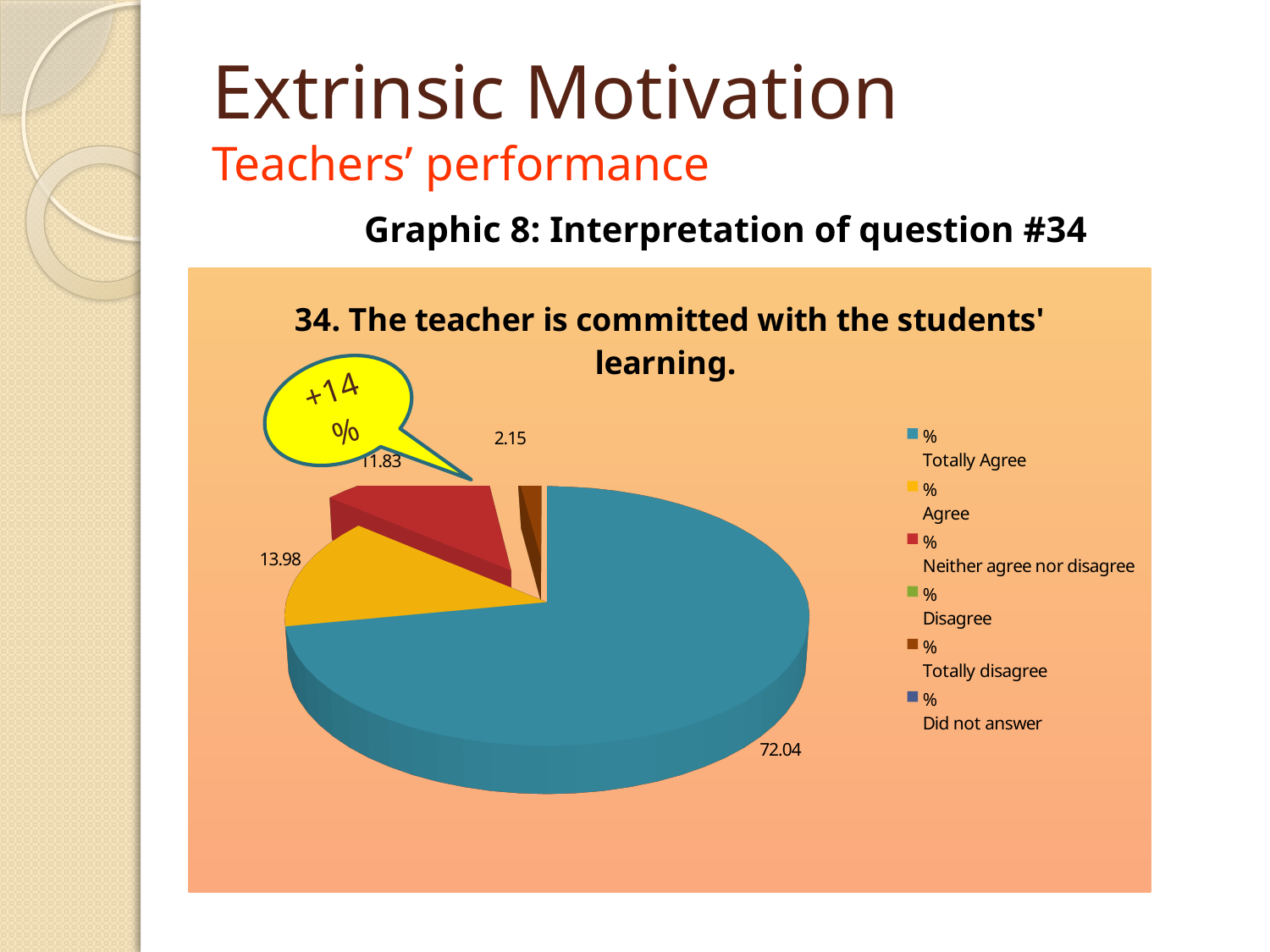
Which category has the largest slice of the pie chart? Totally Agree What kind of chart is shown on the slide? pie chart What is the difference between the values for Agree and Neither agree nor disagree? 2.15 What text is written in the yellow callout bubble on the chart? +14 % What is the value for Totally Agree in the pie chart? 72.04 What is the value for Agree in the pie chart? 13.98 Which is larger, the value for Agree or the value for Neither agree nor disagree? Agree How many entries does the legend of the pie chart list? 6 What is the difference between the values for Totally Agree and Agree? 58.06 What is the value for Neither agree nor disagree in the pie chart? 11.83 What is the title of the pie chart? 34. The teacher is committed with the students' learning. What is the smallest value printed as a data label on the pie chart? 2.15